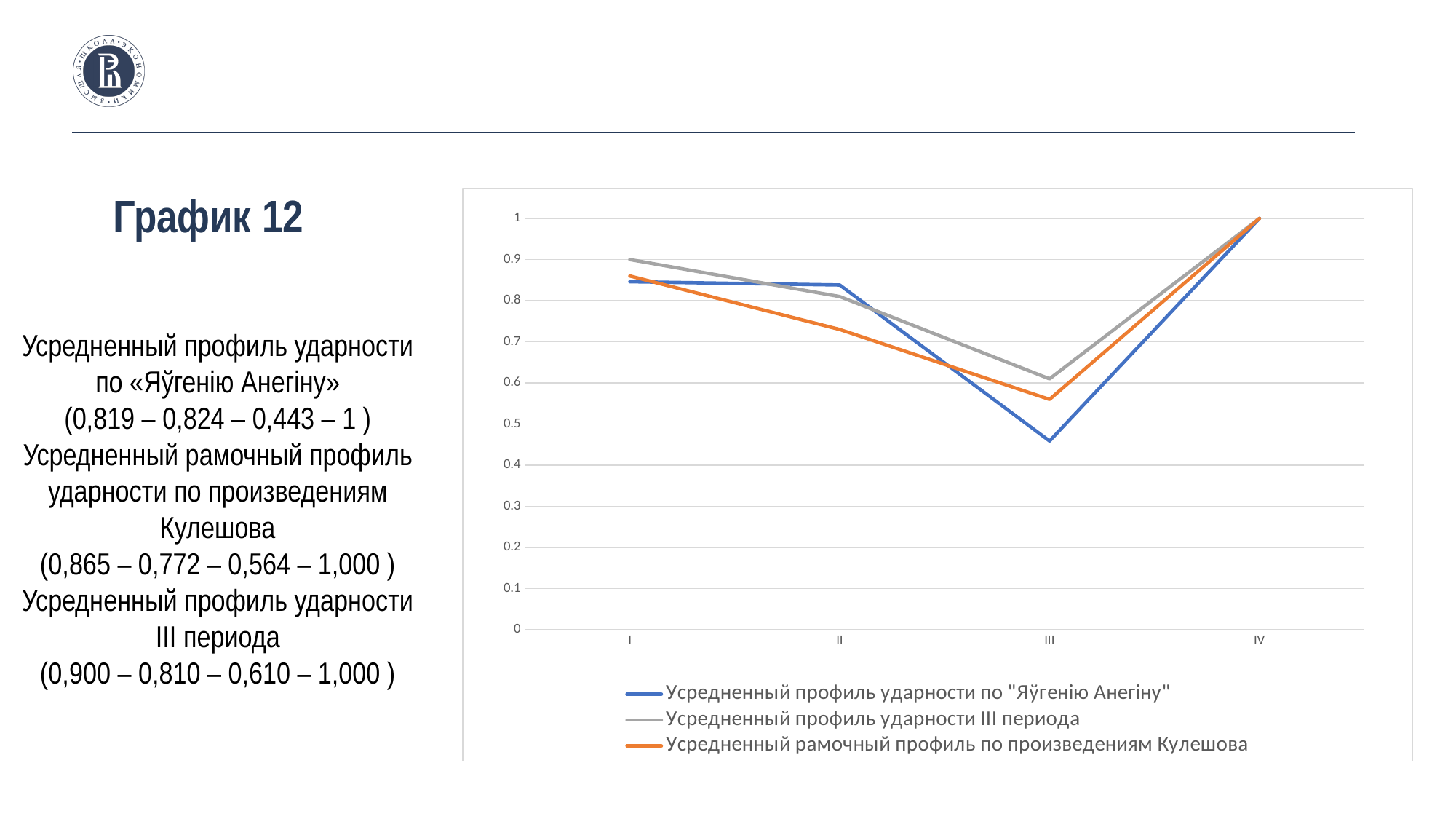
Is the value of the series "Усредненный рамочный профиль по произведениям Кулешова" at II greater or less than 0.7? greater What is the value of the series "Усредненный профиль ударности III периода" at category I? 0.9 Is the value of the series "Усредненный профиль ударности III периода" at III greater or less than 0.7? less How many series does the chart legend list? 3 Does the series "Усредненный профиль ударности по "Яўгенію Анегіну"" rise or fall from II to III? fall What value do all three series reach at category IV? 1 At category III, which series has the larger value: "Усредненный профиль ударности III периода" or "Усредненный профиль ударности по "Яўгенію Анегіну""? Усредненный профиль ударности III периода At which category does the series "Усредненный профиль ударности по "Яўгенію Анегіну"" reach its lowest value? III Is the value of the series "Усредненный профиль ударности по "Яўгенію Анегіну"" at III greater or less than 0.5? less What is the title of the chart given on the slide? График 12 What kind of chart is shown on the slide? line chart How many categories are shown on the x axis of the chart? 4